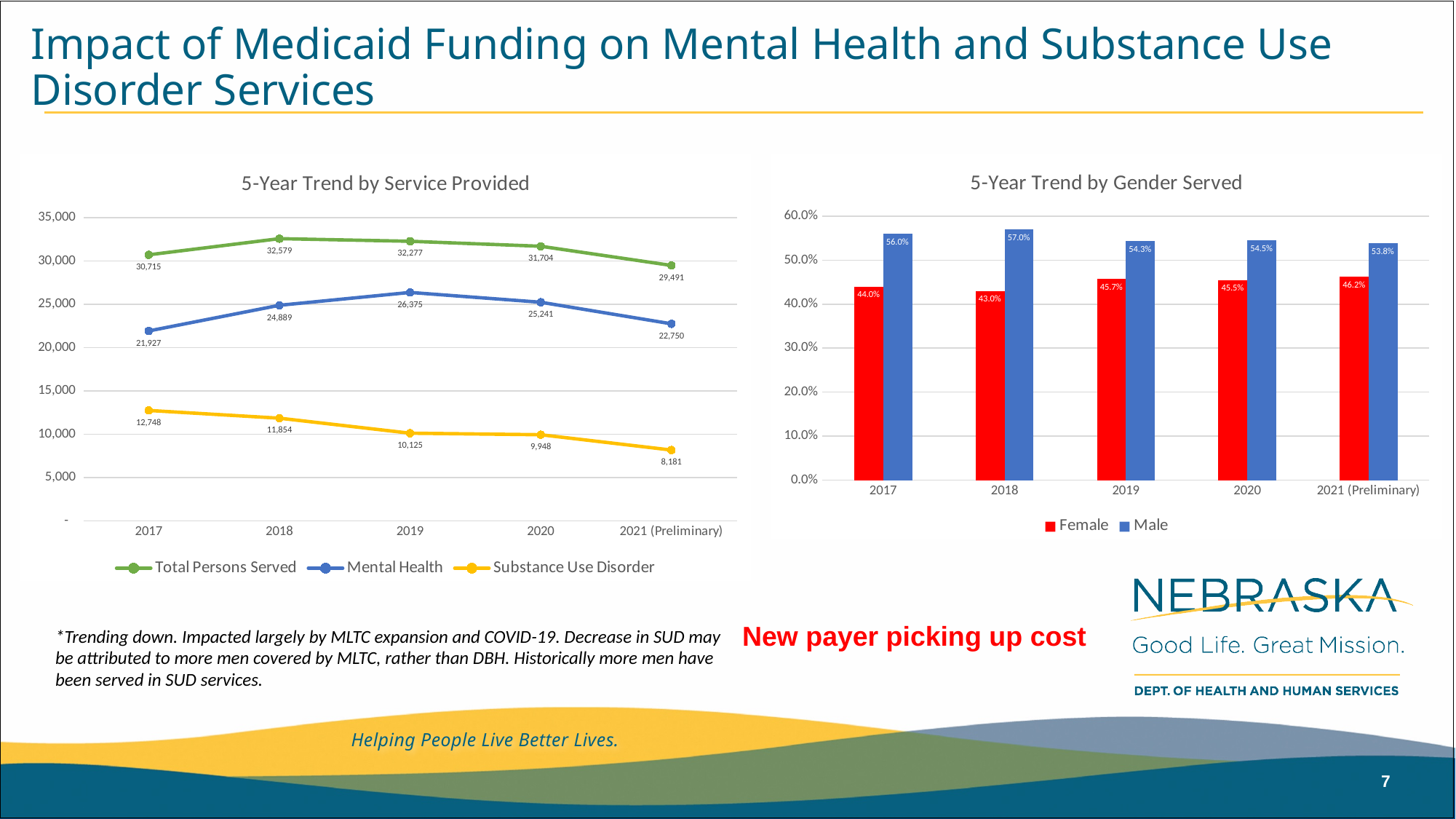
In the '5-Year Trend by Service Provided' chart, how many series does the legend list? 3 In the '5-Year Trend by Service Provided' chart, which year has the highest Mental Health value? 2019 In the '5-Year Trend by Gender Served' chart, which year has the lowest Female value? 2018 In the '5-Year Trend by Service Provided' chart, what is the value for Total Persons Served in 2018? 32,579 In the '5-Year Trend by Gender Served' chart, what is the difference between the Male and Female values in 2021 (Preliminary)? 7.6% In the '5-Year Trend by Gender Served' chart, how many years are shown on the x axis? 5 What kind of chart is '5-Year Trend by Gender Served'? bar chart In the '5-Year Trend by Service Provided' chart, what is the value for Substance Use Disorder in 2021 (Preliminary)? 8,181 In the '5-Year Trend by Gender Served' chart, what is the Male value for 2018? 57.0% What kind of chart is '5-Year Trend by Service Provided'? line chart In the '5-Year Trend by Service Provided' chart, what is the difference between Mental Health in 2019 and Mental Health in 2017? 4,448 In the '5-Year Trend by Service Provided' chart, does the Substance Use Disorder series rise or fall from 2017 to 2021 (Preliminary)? fall